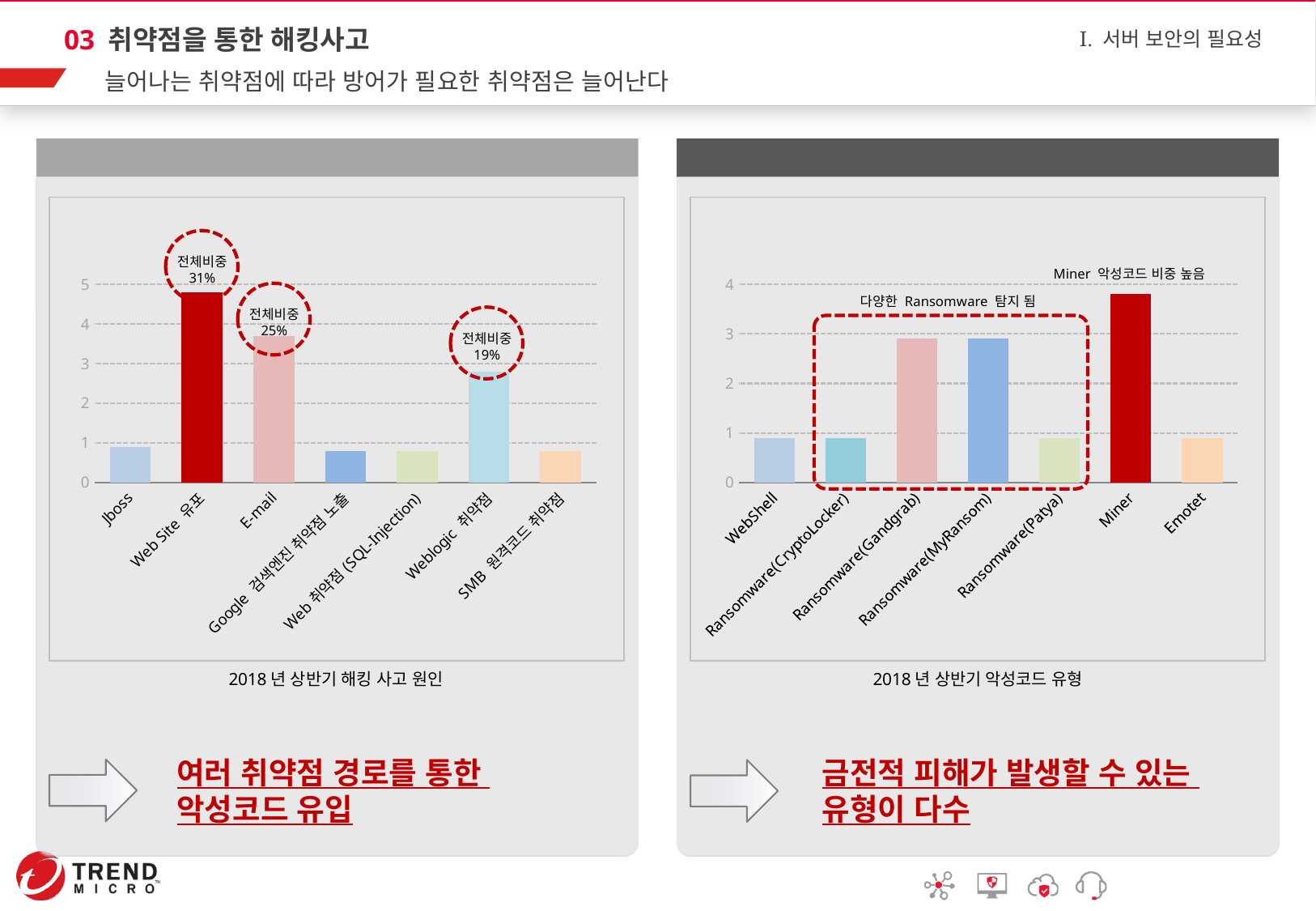
What kind of chart is the left chart titled '2018 년 상반기 해킹 사고 원인'? bar chart In the right chart '2018 년 상반기 악성코드 유형', which is larger, the bar for Ransomware(Gandgrab) or the bar for Ransomware(Patya)? Ransomware(Gandgrab) In the left chart '2018 년 상반기 해킹 사고 원인', what 전체비중 is labelled for Web Site 유포? 31% In the right chart '2018 년 상반기 악성코드 유형', is the value for Miner greater or less than 3? greater In the right chart '2018 년 상반기 악성코드 유형', which category has the highest bar? Miner In the left chart '2018 년 상반기 해킹 사고 원인', is the value for Web Site 유포 greater or less than 4? greater In the left chart '2018 년 상반기 해킹 사고 원인', which category has the highest bar? Web Site 유포 In the left chart '2018 년 상반기 해킹 사고 원인', how many categories are shown on the x axis? 7 In the left chart '2018 년 상반기 해킹 사고 원인', what 전체비중 is labelled for E-mail? 25% In the left chart '2018 년 상반기 해킹 사고 원인', what 전체비중 is labelled for Weblogic 취약점? 19% In the left chart '2018 년 상반기 해킹 사고 원인', which is larger, the bar for E-mail or the bar for Weblogic 취약점? E-mail In the right chart '2018 년 상반기 악성코드 유형', how many categories are shown on the x axis? 7